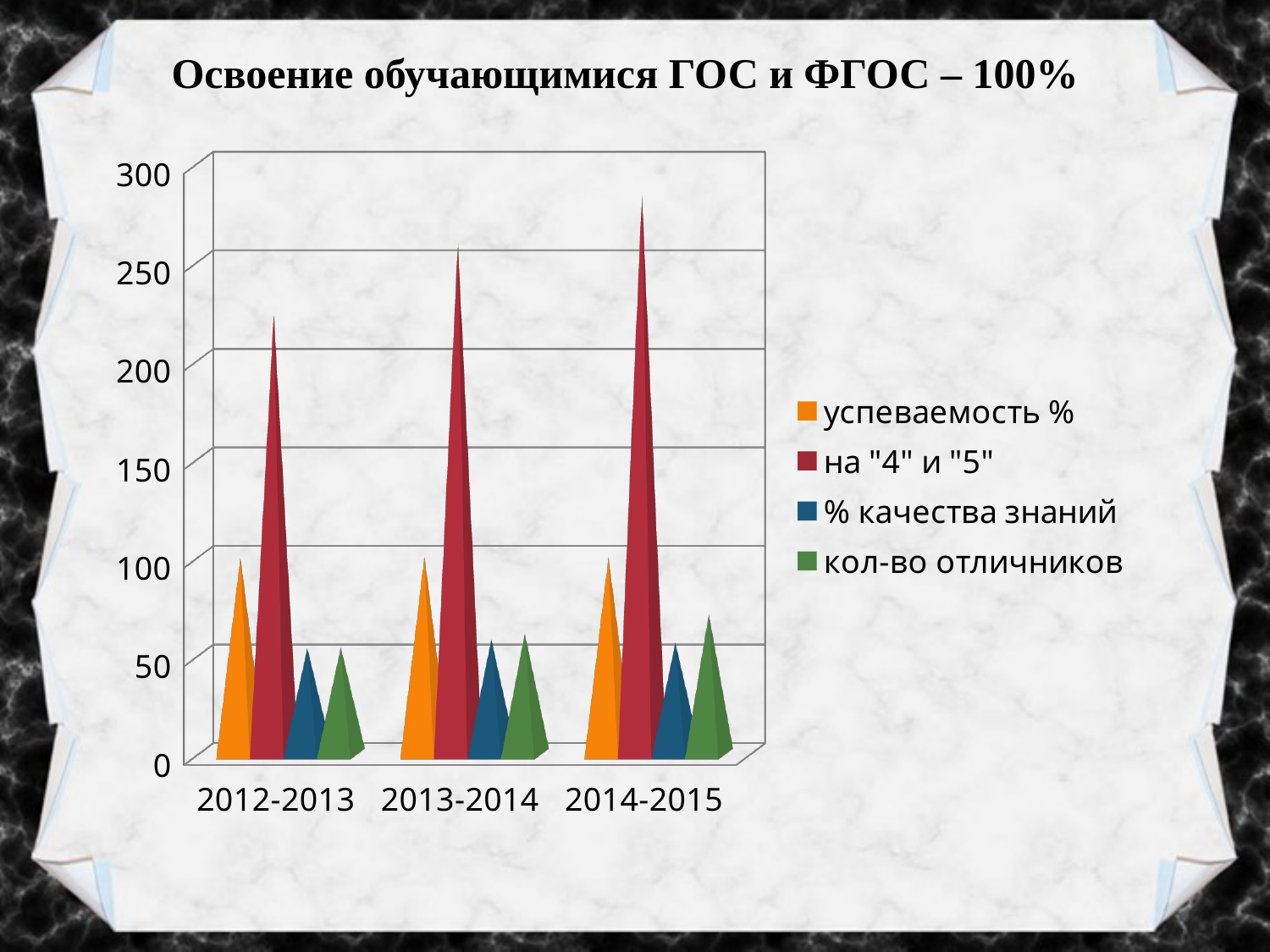
Which series is shown in red? на "4" и "5" How many series does the legend list? 4 Which is larger: на "4" и "5" in 2013-2014 or успеваемость % in 2013-2014? на "4" и "5" Is the value for кол-во отличников in 2014-2015 greater or less than 50? greater In which year is the value for на "4" и "5" the highest? 2014-2015 How many categories are shown on the x axis? 3 Do the values for на "4" и "5" rise or fall from 2012-2013 to 2014-2015? rise In which year is the value for на "4" и "5" the lowest? 2012-2013 Is the value for на "4" и "5" in 2014-2015 greater or less than 250? greater What kind of chart is shown on the slide? bar chart What is the title of the chart? Освоение обучающимися ГОС и ФГОС – 100% Is the value for на "4" и "5" in 2012-2013 greater or less than 250? less